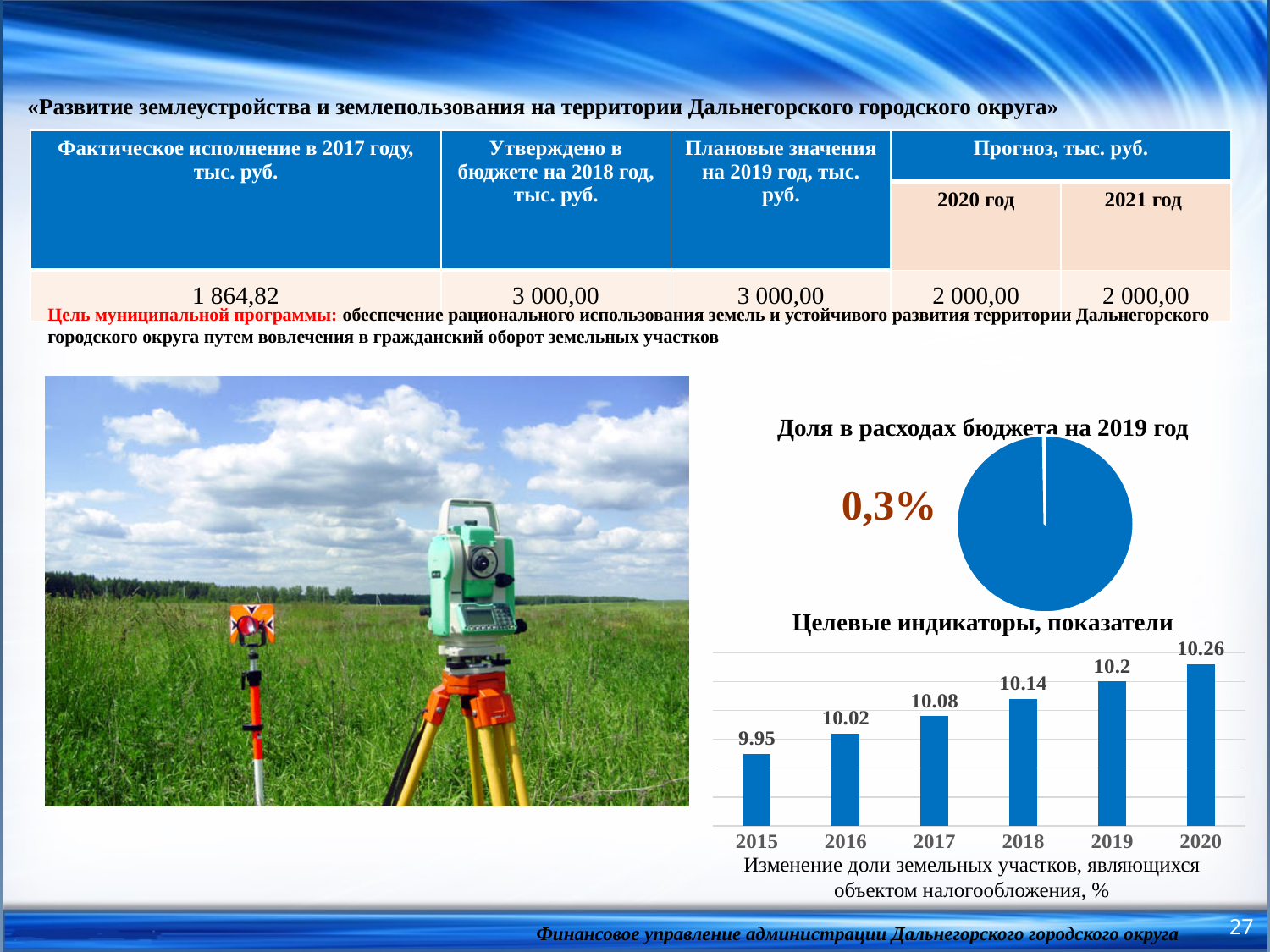
In the chart titled "Целевые индикаторы, показатели", what is the value for 2018? 10.14 In the chart titled "Целевые индикаторы, показатели", which is larger, the value for 2017 or the value for 2019? 2019 How many bars are shown in the chart titled "Целевые индикаторы, показатели"? 6 In the chart titled "Целевые индикаторы, показатели", which year has the lowest value? 2015 In the chart titled "Целевые индикаторы, показатели", what is the value for 2020? 10.26 In the pie chart titled "Доля в расходах бюджета на 2019 год", what share is labelled on the slide? 0,3% What kind of chart is the one titled "Целевые индикаторы, показатели"? bar chart In the chart titled "Целевые индикаторы, показатели", do the values rise or fall from 2015 to 2020? rise In the chart titled "Целевые индикаторы, показатели", what is the value for 2015? 9.95 In the chart titled "Целевые индикаторы, показатели", what is the difference between the values for 2020 and 2015? 0.31 In the chart titled "Целевые индикаторы, показатели", which year has the highest value? 2020 What kind of chart is the one titled "Доля в расходах бюджета на 2019 год"? pie chart